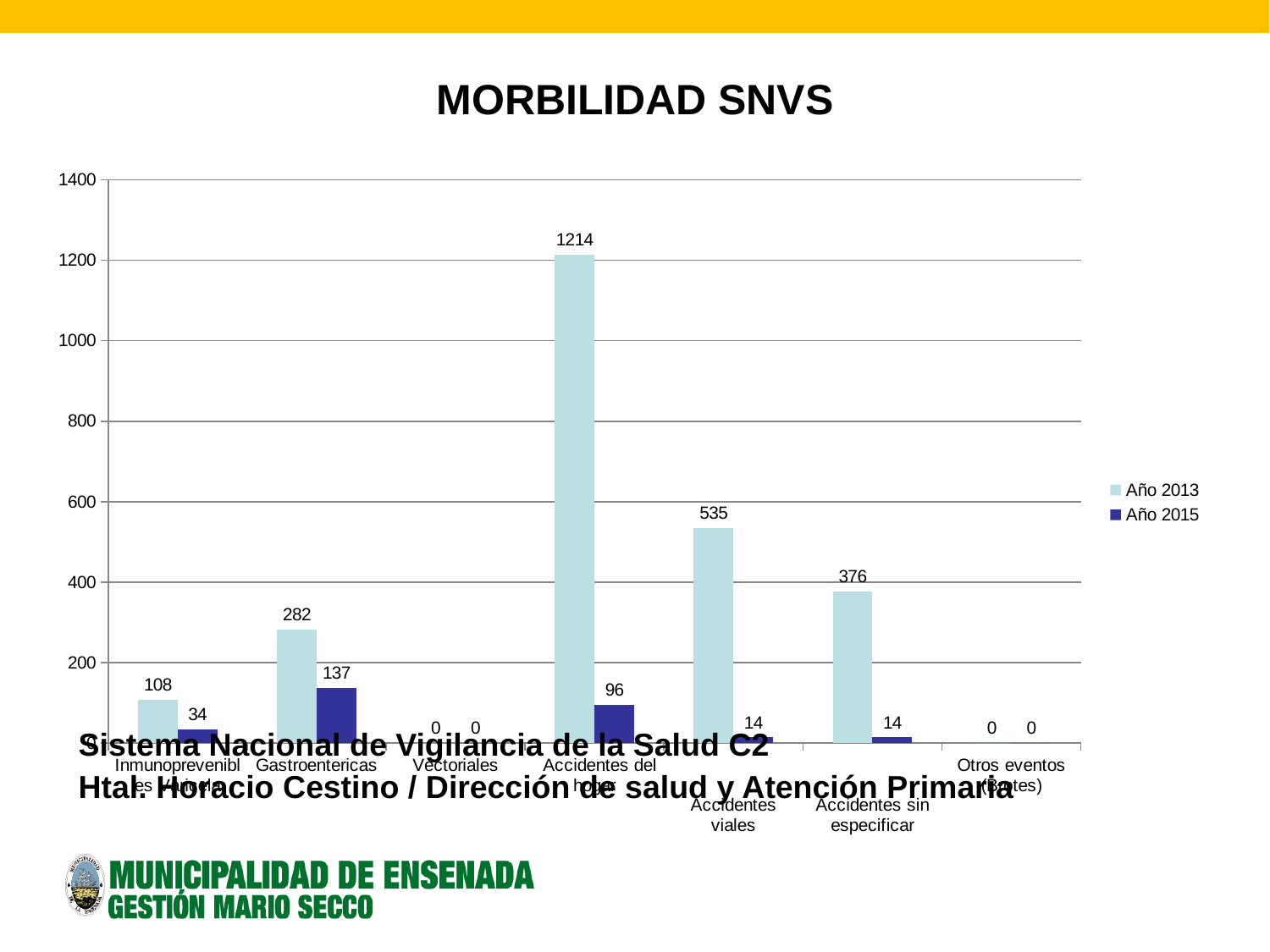
What is the highest value in the Año 2013 series? 1214 What is the title of the chart? MORBILIDAD SNVS What is the Año 2013 value for Vectoriales? 0 What is the difference between the Año 2013 and Año 2015 values for Gastroentericas? 145 What is the Año 2015 value for Gastroentericas? 137 What type of chart is shown on the slide? Bar chart Which is larger for Accidentes sin especificar, the Año 2013 value or the Año 2015 value? Año 2013 What is the Año 2015 value for Accidentes sin especificar? 14 What is the Año 2013 value for Accidentes viales? 535 What is the difference between the Año 2013 and Año 2015 values for Accidentes viales? 521 How many series does the legend list? 2 What is the Año 2013 value for Gastroentericas? 282